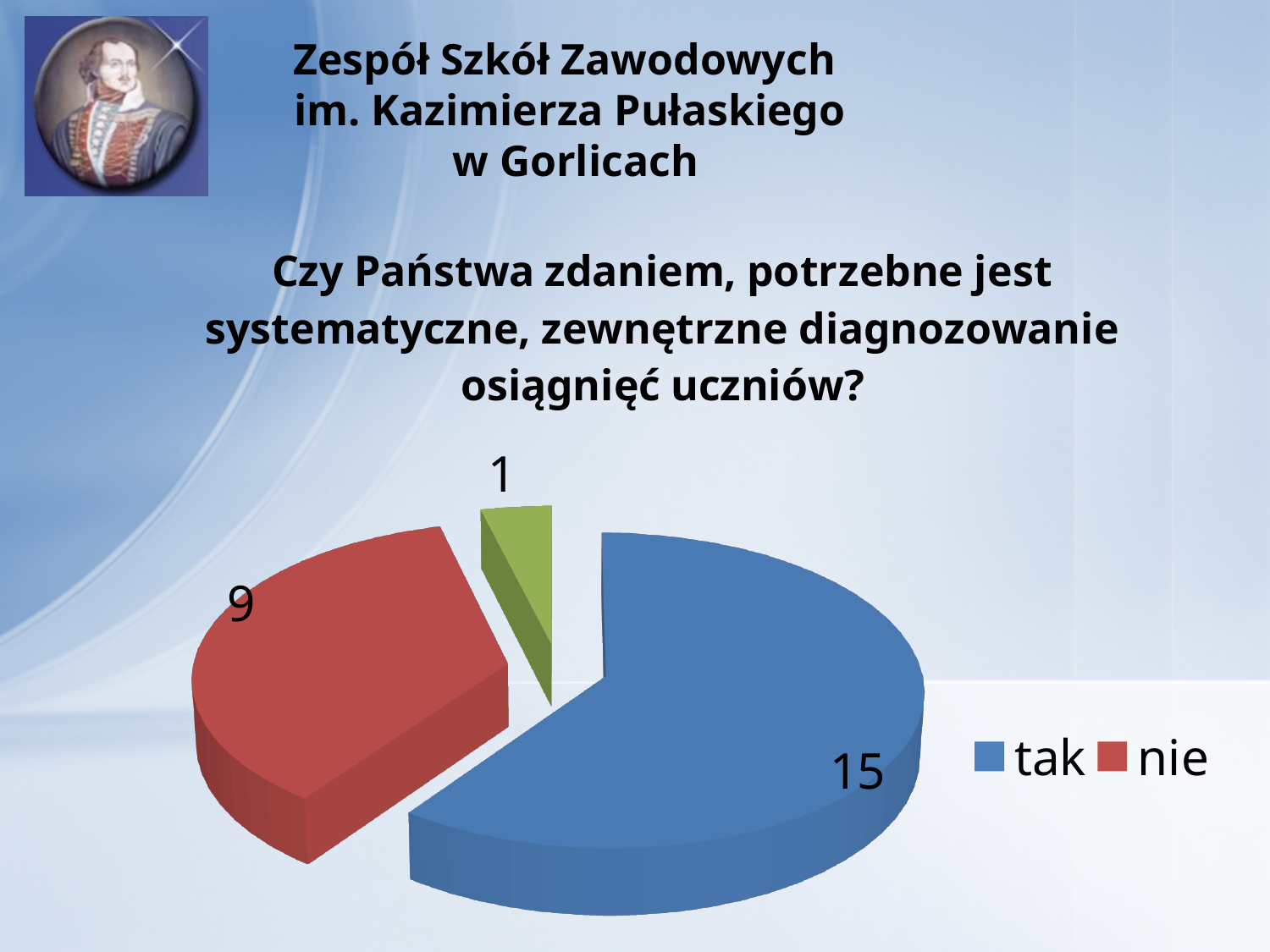
What is the total of all the values shown on the pie chart? 25 What share of the pie does the "tak" slice represent? 60% What is the difference between the values for "tak" and "nie"? 6 What colour is the "nie" slice in the pie chart? red What is the value for "tak" in the pie chart? 15 Which is larger, the value for "tak" or the value for "nie"? tak Which category has the largest slice in the pie chart? tak What is the value for "nie" in the pie chart? 9 What is the smallest value shown on the pie chart? 1 What kind of chart is shown on the slide? pie chart How many entries does the legend list? 2 How many slices does the pie chart have? 3